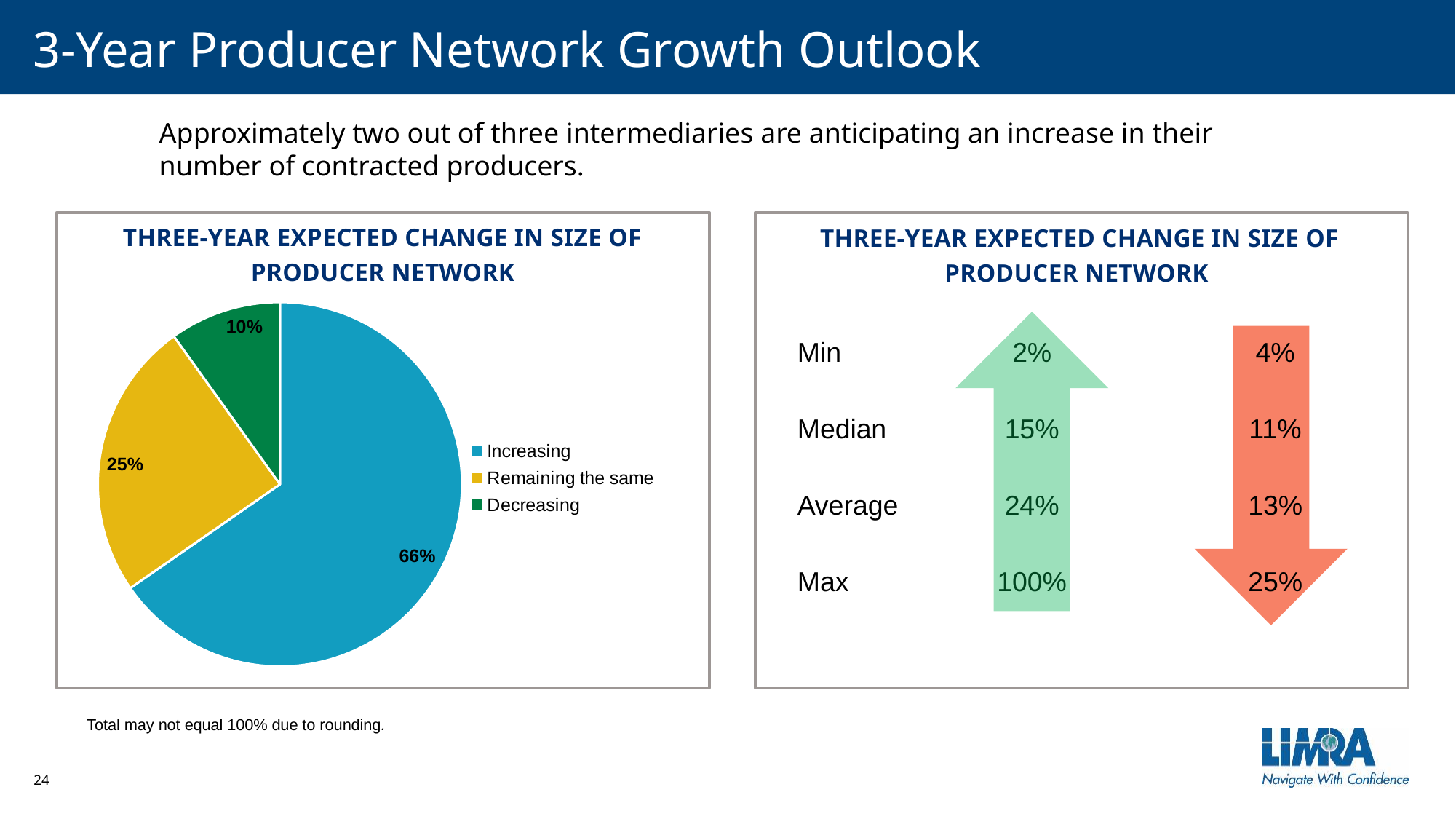
In the pie chart on the left, which category has the smallest slice? Decreasing In the pie chart on the left, what percentage is shown for 'Decreasing'? 10% How many slices does the pie chart on the left have? 3 In the pie chart on the left, what share is labelled for 'Remaining the same'? 25% In the graphic on the right, what is the median expected increase in producer network size? 15% In the pie chart on the left, what percentage of intermediaries expect their producer network to be increasing? 66% What type of chart is shown on the left side of the slide? Pie chart In the pie chart on the left, which is larger: 'Remaining the same' or 'Decreasing'? Remaining the same In the pie chart on the left, which category has the largest slice? Increasing In the pie chart on the left, what colour is the 'Increasing' slice? Blue In the graphic on the right, what is the maximum expected decrease in producer network size? 25% In the pie chart on the left, what is the difference in percentage points between 'Increasing' and 'Remaining the same'? 41